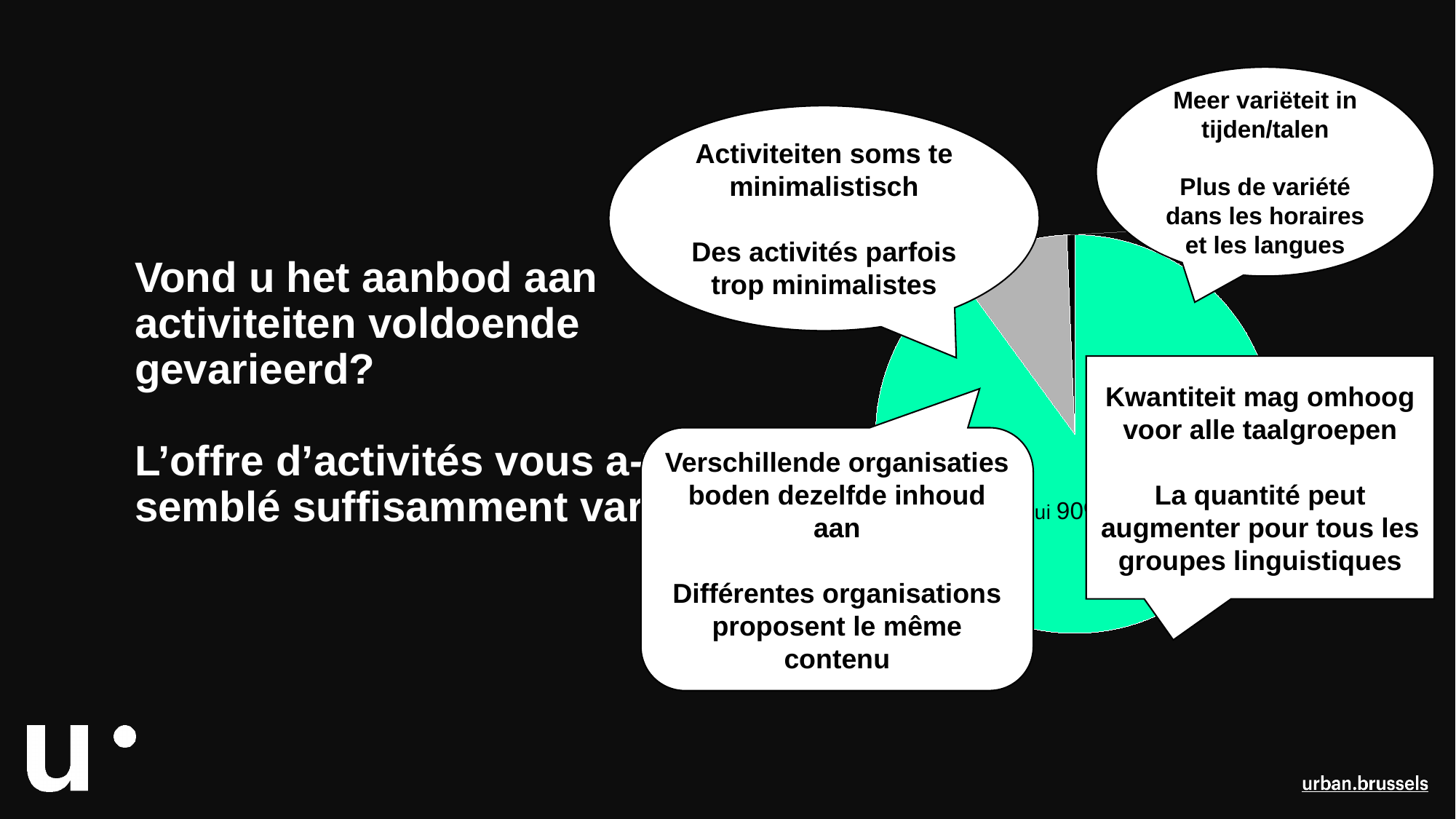
Which slice of the pie chart is the largest? the green slice What kind of chart is shown on the slide? pie chart Which slice of the pie chart is larger, the green slice or the grey slice? the green slice What colour is the largest slice of the pie chart? green